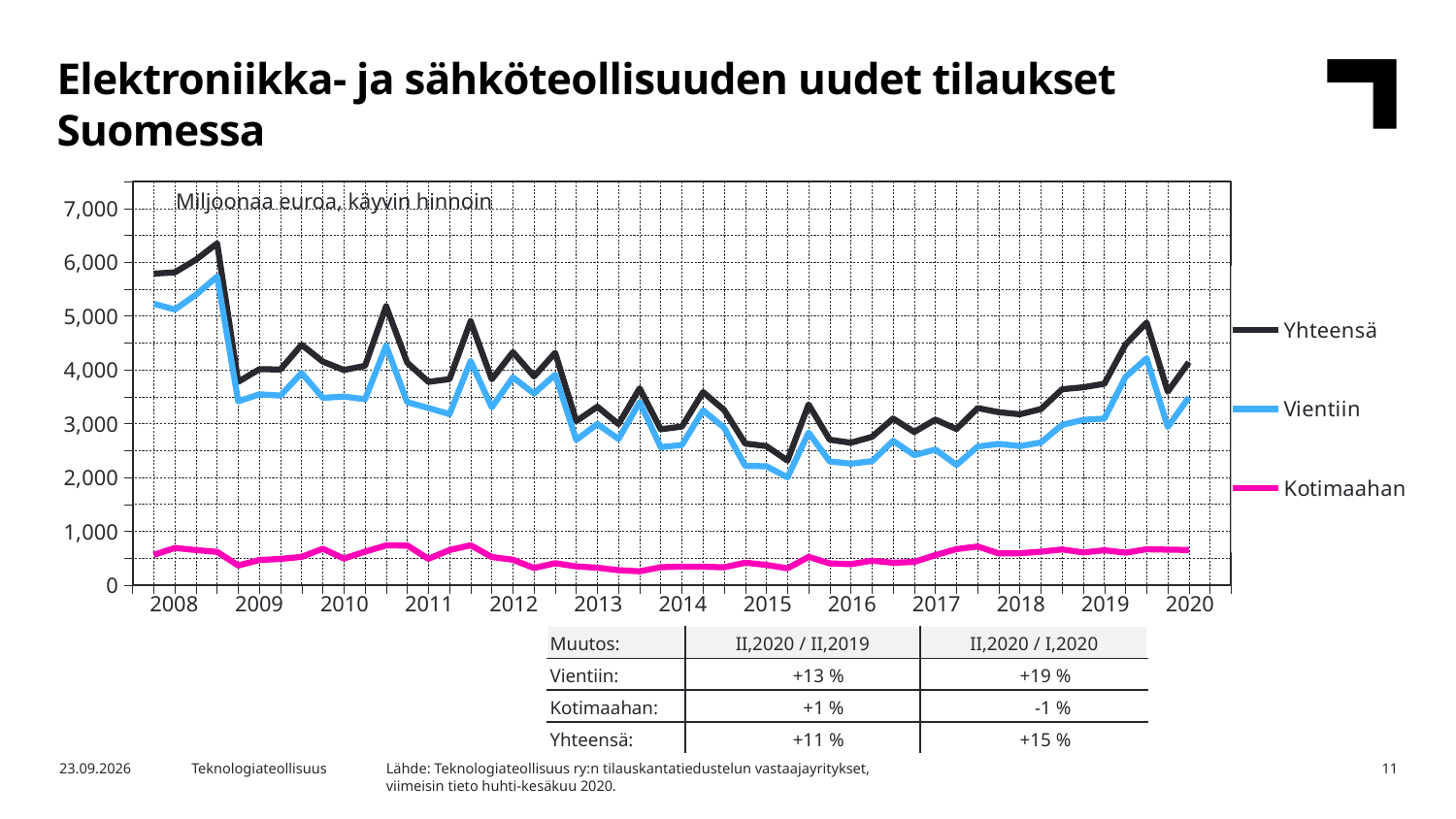
Is the peak value for Yhteensä in 2008 greater or less than 6,000? greater Does the Yhteensä line generally rise or fall from 2008 to 2016? Fall Is the value for Yhteensä in 2016 greater or less than 4,000? less What unit is stated in the text at the top of the chart area? Miljoonaa euroa, käyvin hinnoin Which series has the larger value in 2019, Vientiin or Kotimaahan? Vientiin How many year labels are shown on the x axis? 13 Which series is plotted with the highest values throughout the chart? Yhteensä What kind of chart is shown on the slide? Line chart Is the value for Kotimaahan in 2008 greater or less than 1,000? less Which series is plotted with the lowest values throughout the chart? Kotimaahan How many series does the legend list? 3